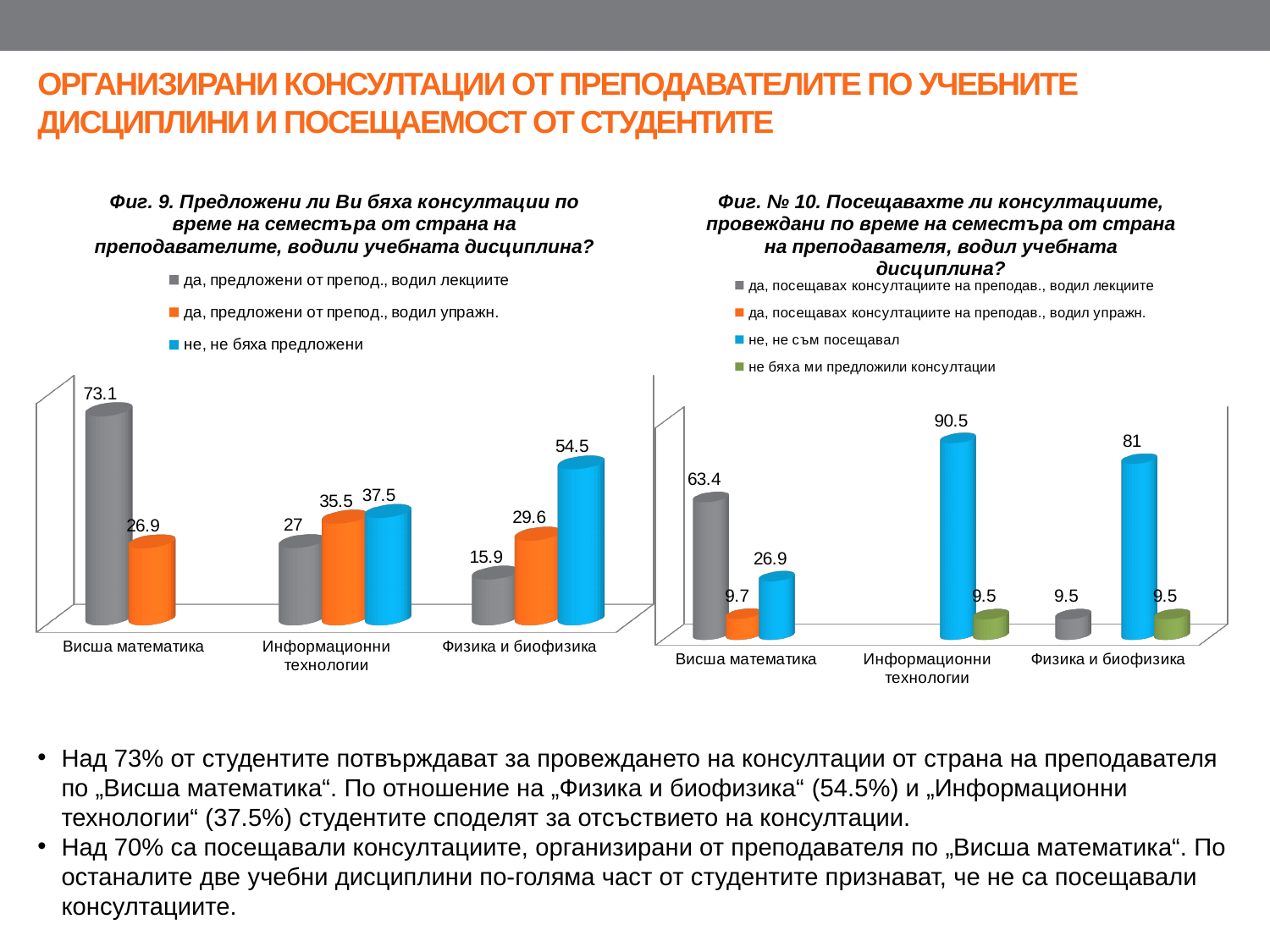
In the chart titled "Фиг. 9", how many series does the legend list? 3 What kind of chart is the chart titled "Фиг. № 10"? Bar chart In the chart titled "Фиг. № 10", what is the value for "не, не съм посещавал" for Информационни технологии? 90.5 In the chart titled "Фиг. № 10", how many series does the legend list? 4 In the chart titled "Фиг. 9", what is the value for "не, не бяха предложени" for Физика и биофизика? 54.5 In the chart titled "Фиг. № 10", which is larger: the "не, не съм посещавал" value for Информационни технологии or for Физика и биофизика? Информационни технологии In the chart titled "Фиг. № 10", which category has the lowest value for "не, не съм посещавал"? Висша математика In the chart titled "Фиг. 9", which category has the highest value for "да, предложени от препод., водил лекциите"? Висша математика In the chart titled "Фиг. 9", what is the value for "да, предложени от препод., водил лекциите" for Висша математика? 73.1 In the chart titled "Фиг. 9", what is the value for "да, предложени от препод., водил упражн." for Информационни технологии? 35.5 In the chart titled "Фиг. 9", what is the difference between the "не, не бяха предложени" values for Физика и биофизика and Информационни технологии? 17 In the chart titled "Фиг. № 10", what is the value for "да, посещавах консултациите на преподав., водил лекциите" for Висша математика? 63.4